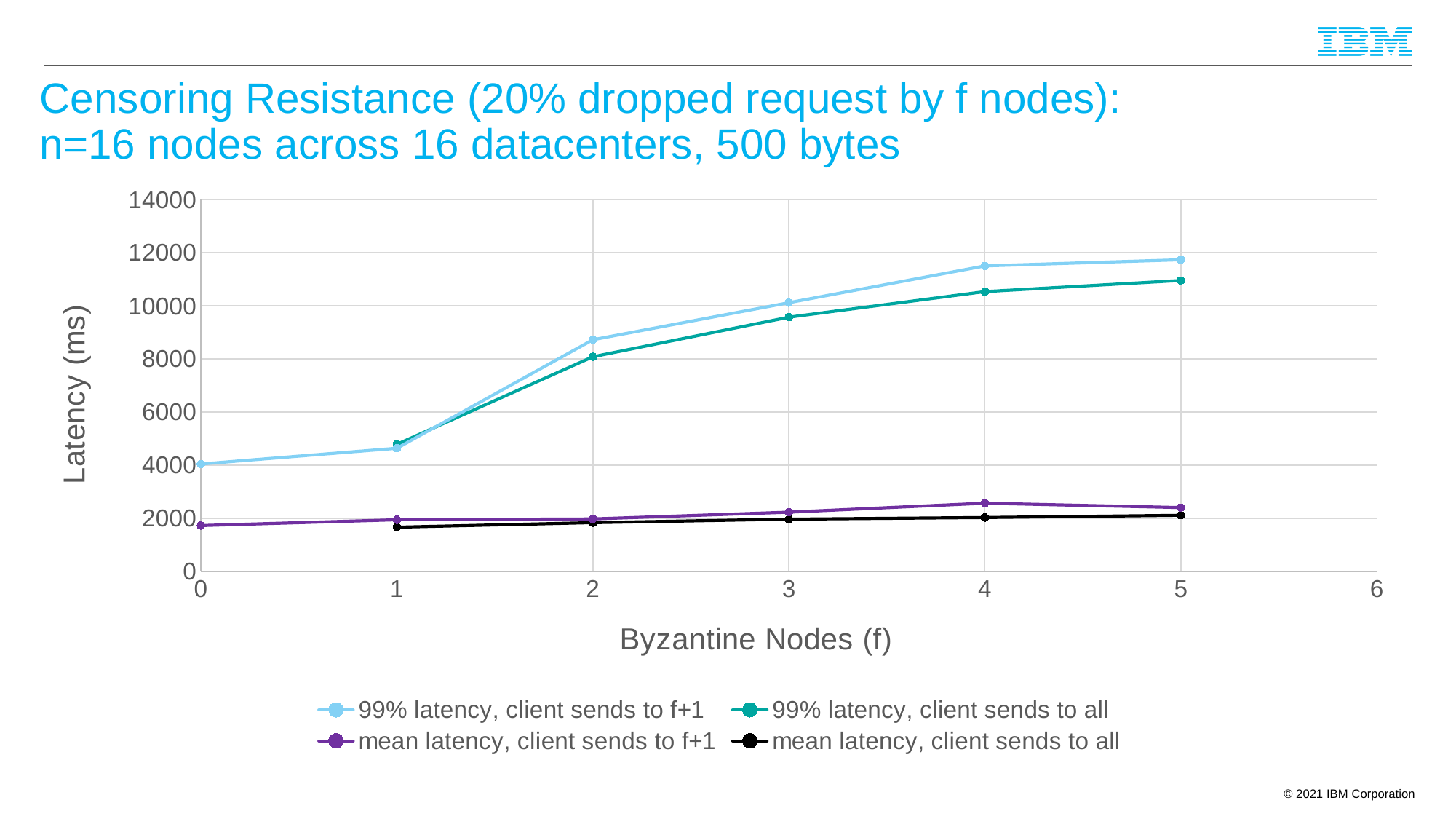
Is the value of '99% latency, client sends to f+1' at f=5 greater or less than 10000? greater What is the label of the x axis? Byzantine Nodes (f) At f=4, which series is higher: 'mean latency, client sends to f+1' or 'mean latency, client sends to all'? mean latency, client sends to f+1 Is the value of 'mean latency, client sends to all' at f=1 greater or less than 2000? less Is the value of '99% latency, client sends to f+1' at f=0 greater or less than 6000? less How many series does the legend list? 4 What kind of chart is shown on the slide? line chart At which number of Byzantine nodes is '99% latency, client sends to f+1' highest? 5 What is the label of the y axis? Latency (ms) Does the '99% latency, client sends to f+1' series rise or fall as the number of Byzantine nodes increases? rise At f=5, which series is higher: '99% latency, client sends to f+1' or '99% latency, client sends to all'? 99% latency, client sends to f+1